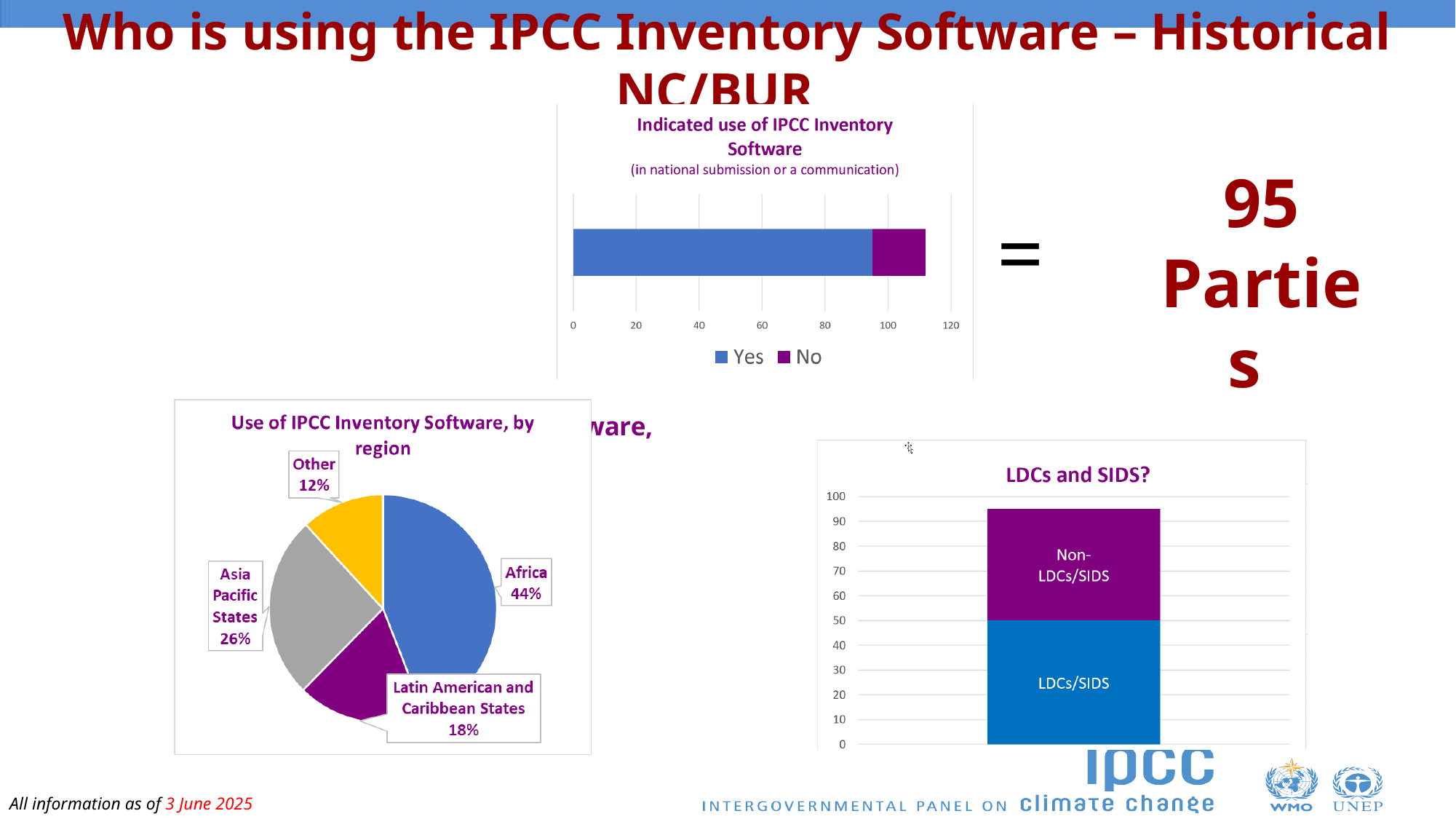
In the pie chart 'Use of IPCC Inventory Software, by region', how many slices are there? 4 In the chart 'LDCs and SIDS?', is the LDCs/SIDS segment greater or less than 40? greater In the chart 'Indicated use of IPCC Inventory Software', how many series does the legend list? 2 In the pie chart 'Use of IPCC Inventory Software, by region', how many percentage points larger is Africa's share than Asia Pacific States' share? 18 In the chart 'Indicated use of IPCC Inventory Software', is the 'Yes' value greater or less than 80? greater In the pie chart 'Use of IPCC Inventory Software, by region', which region has the largest share? Africa What kind of chart is 'Use of IPCC Inventory Software, by region'? Pie chart In the pie chart 'Use of IPCC Inventory Software, by region', which slice is the smallest? Other In the pie chart 'Use of IPCC Inventory Software, by region', what share is Latin American and Caribbean States? 18% In the pie chart 'Use of IPCC Inventory Software, by region', what share is Africa? 44% In the chart 'Indicated use of IPCC Inventory Software', which is larger, Yes or No? Yes In the pie chart 'Use of IPCC Inventory Software, by region', what share is Asia Pacific States? 26%